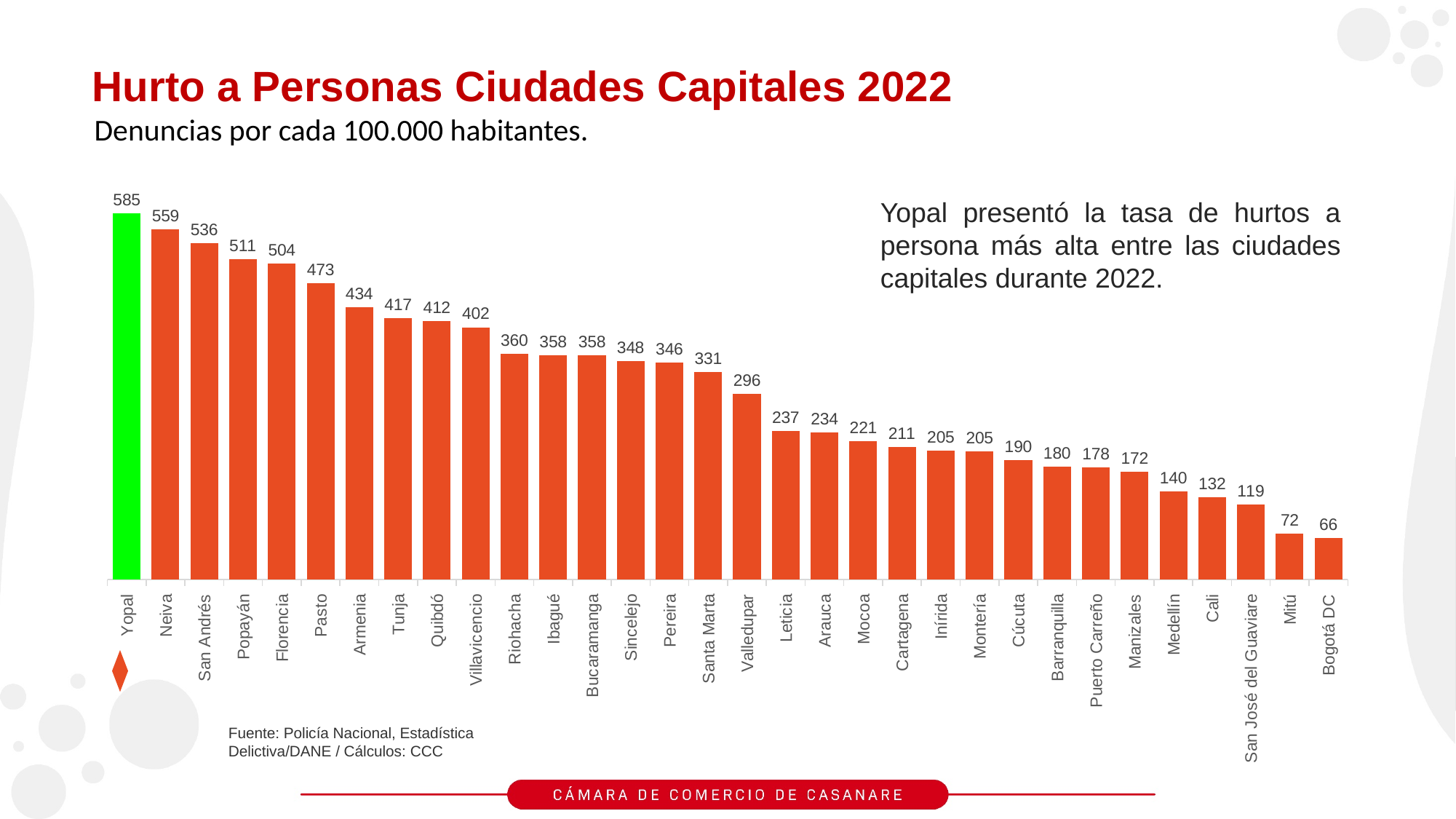
What is the value for Villavicencio? 402 Which city has the lowest value? Bogotá DC What is the value for Yopal? 585 What kind of chart is shown on the slide? Bar chart What is the difference between the values for Mitú and Bogotá DC? 6 Which is larger, the value for Pasto or the value for Armenia? Pasto Which city has the highest value? Yopal Which bar is coloured green instead of orange? Yopal What is the difference between the values for Yopal and Neiva? 26 How many cities are shown in the chart? 32 What is the value for Bogotá DC? 66 What is the value for Medellín? 140